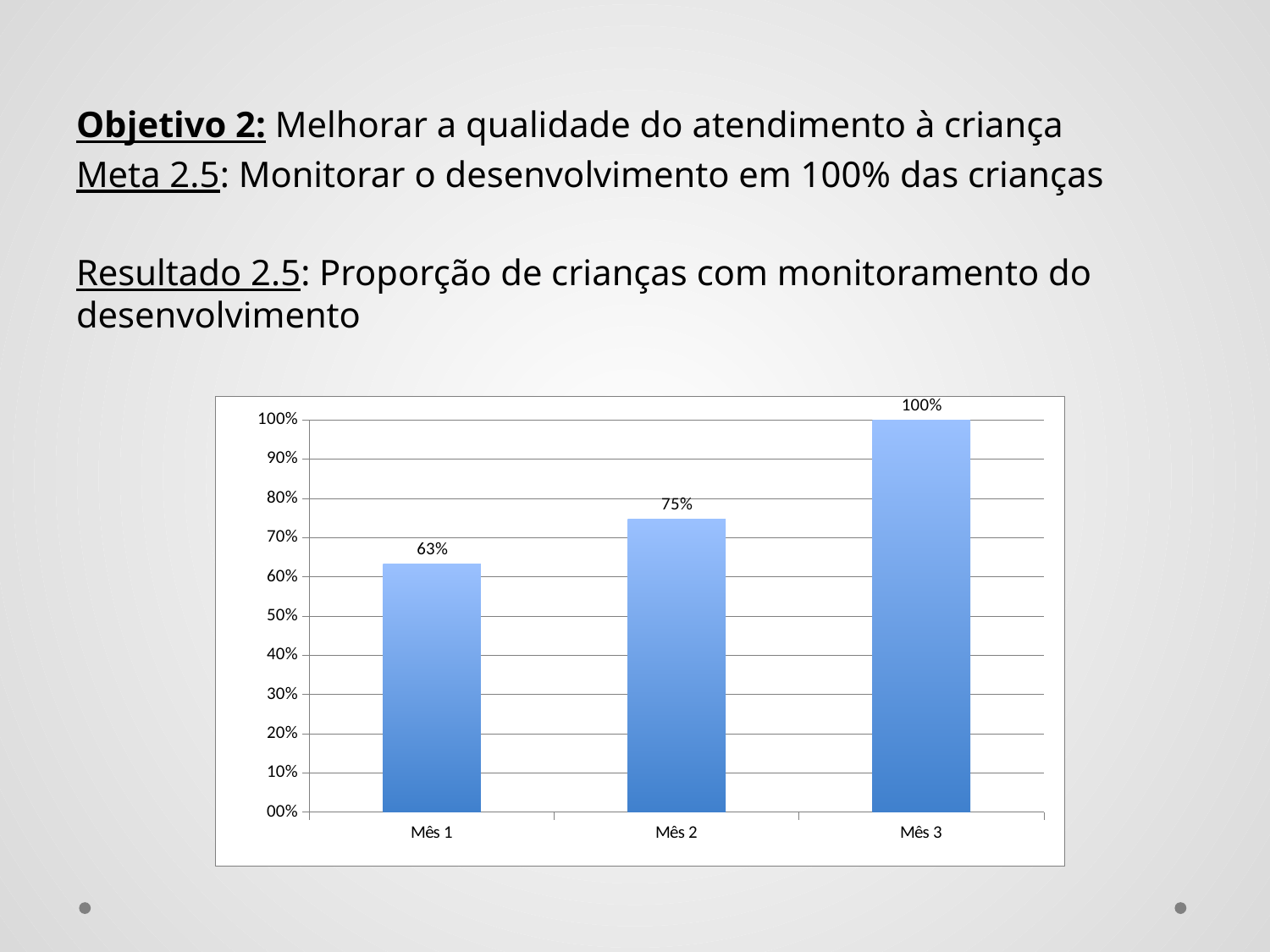
What is the value for Mês 3? 100% What is the value for Mês 2? 75% What is the difference between the values for Mês 3 and Mês 1? 37% What is the value for Mês 1? 63% Is the value for Mês 2 greater or less than 70%? greater How many months are shown on the x axis? 3 What kind of chart is shown on the slide? bar chart Which month has the highest value? Mês 3 Which month has the lowest value? Mês 1 Do the values rise or fall from Mês 1 to Mês 3? rise What is the difference between the values for Mês 2 and Mês 1? 12% Which is larger, the value for Mês 1 or the value for Mês 2? Mês 2